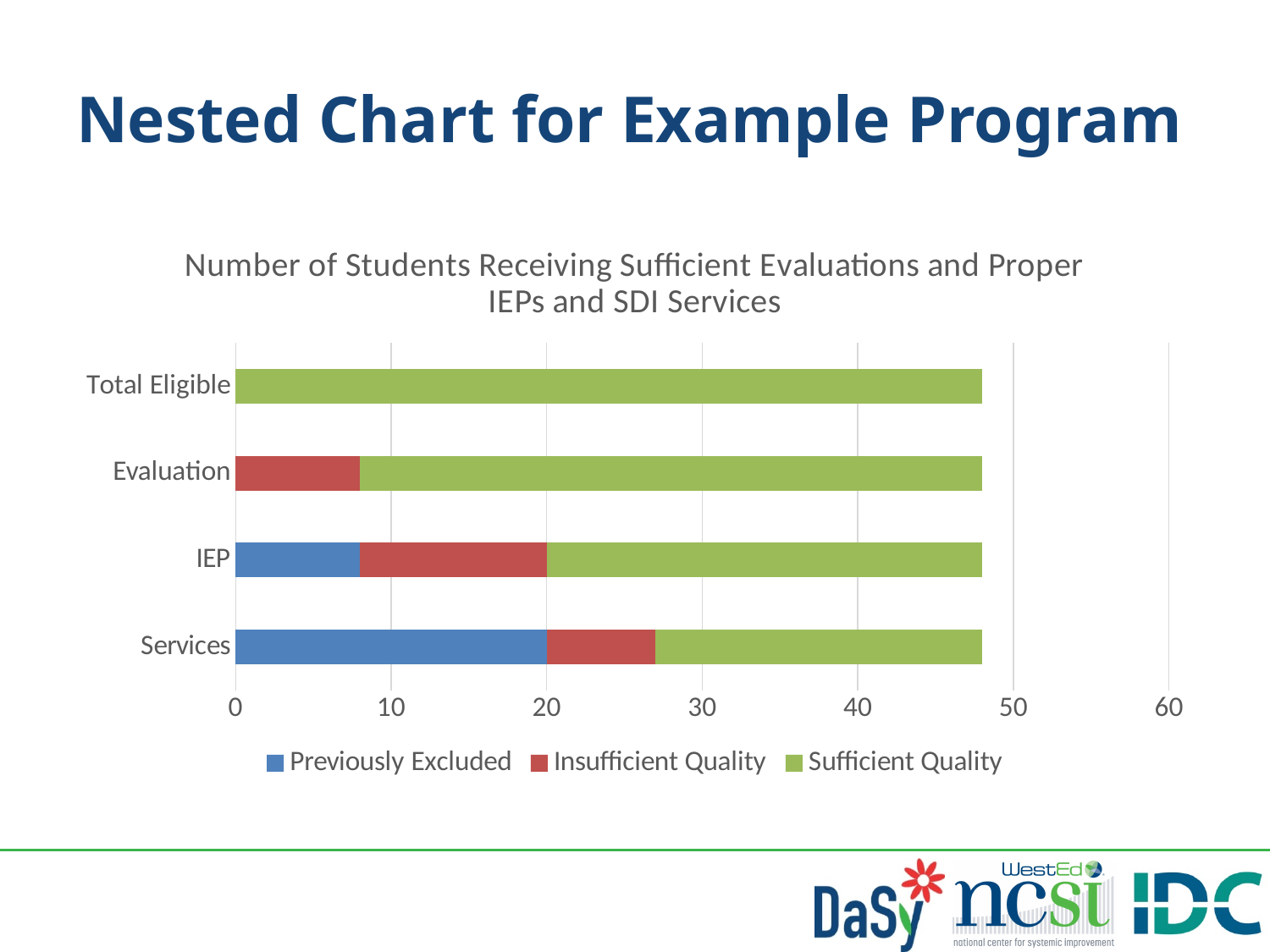
How many categories are shown on the vertical axis of the chart? 4 Which category has the smallest Sufficient Quality segment? Services Is the Previously Excluded value for Services greater or less than 10? greater Which series is shown in green in the chart? Sufficient Quality How many series does the chart legend list? 3 Which category has the largest Previously Excluded segment? Services Is the total length of the Total Eligible bar greater or less than 40? greater What kind of chart is shown on the slide? Stacked bar chart Which has a larger Insufficient Quality value, IEP or Evaluation? IEP Which has a larger Previously Excluded value, Services or IEP? Services What is the title of the chart? Number of Students Receiving Sufficient Evaluations and Proper IEPs and SDI Services Is the Insufficient Quality value for Evaluation greater or less than 10? less